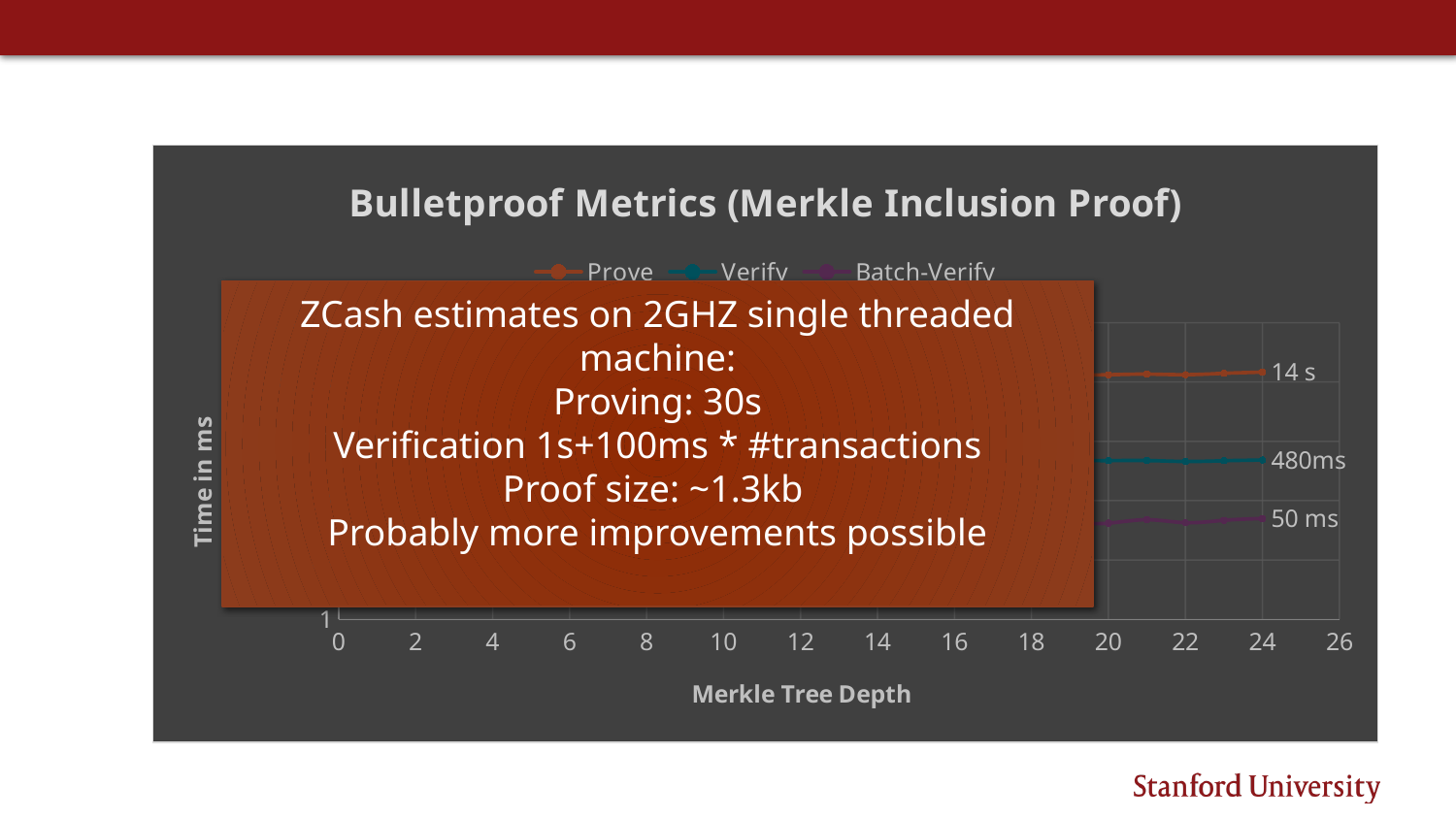
What value is labelled at the right end of the Batch-Verify line? 50 ms How many series does the chart's legend list? 3 What value is labelled at the right end of the Prove line? 14 s Which is larger at the right end of the chart, the Verify value or the Batch-Verify value? Verify What is the largest tick value shown on the x axis? 26 What value is labelled at the right end of the Verify line? 480ms What kind of chart is shown on the slide? line chart What is the label on the x axis of the chart? Merkle Tree Depth Which series has the highest values in the visible part of the chart? Prove What is the title of the chart? Bulletproof Metrics (Merkle Inclusion Proof) Which series has the lowest values in the visible part of the chart? Batch-Verify Do the Prove values rise sharply, fall sharply, or stay roughly flat between Merkle tree depth 20 and 24? stay roughly flat